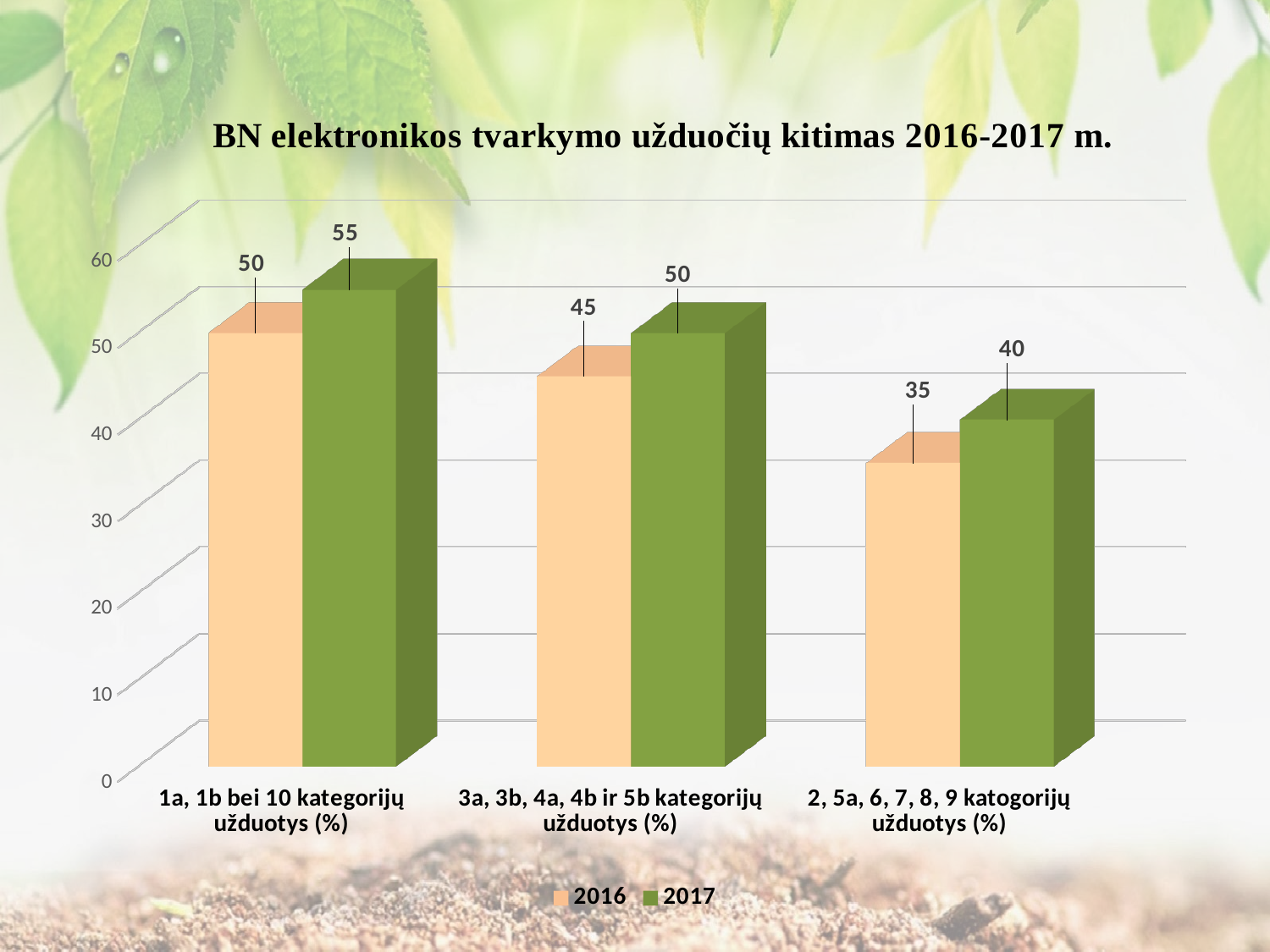
Do the 2016 values rise or fall from left to right across the categories? Fall What is the difference between the 2017 and 2016 values in the category "2, 5a, 6, 7, 8, 9 katogorijų užduotys (%)"? 5 Which category has the lowest value for 2016? 2, 5a, 6, 7, 8, 9 katogorijų užduotys (%) Which category has the highest value for 2017? 1a, 1b bei 10 kategorijų užduotys (%) What kind of chart is shown on the slide? Bar chart How many series does the legend list? 2 What is the value for 2016 in the category "2, 5a, 6, 7, 8, 9 katogorijų užduotys (%)"? 35 What is the value for 2016 in the category "1a, 1b bei 10 kategorijų užduotys (%)"? 50 What is the title of the chart? BN elektronikos tvarkymo užduočių kitimas 2016-2017 m. Which is larger in the category "3a, 3b, 4a, 4b ir 5b kategorijų užduotys (%)": the 2016 value or the 2017 value? 2017 What is the value for 2017 in the category "3a, 3b, 4a, 4b ir 5b kategorijų užduotys (%)"? 50 How many categories are shown on the x axis? 3